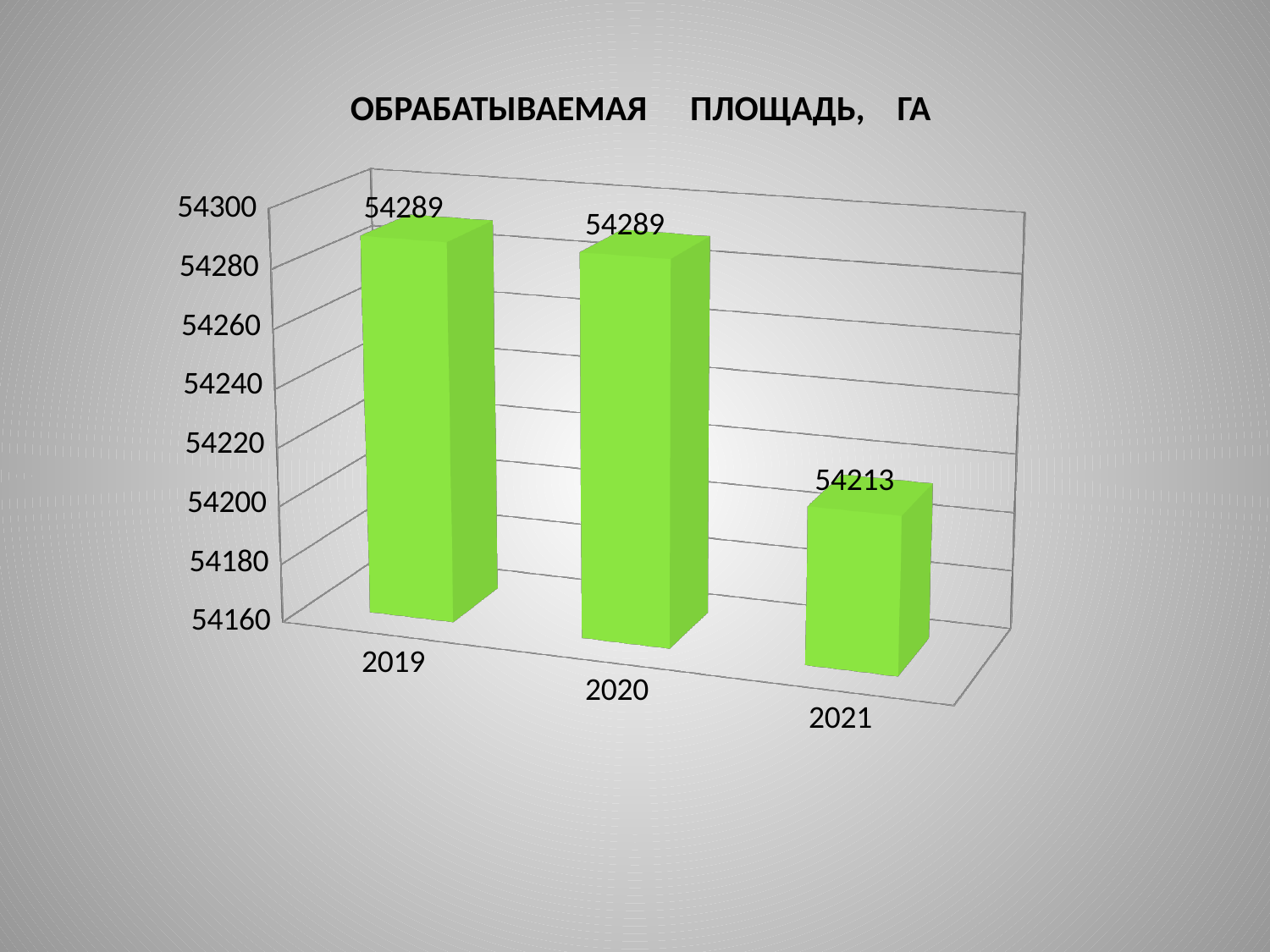
What is the title of the chart? ОБРАБАТЫВАЕМАЯ ПЛОЩАДЬ, ГА Which is larger, the value for 2019 or the value for 2021? 2019 How many years are shown on the chart? 3 Is the value for 2020 greater or less than 54260? greater Is the value for 2021 greater or less than 54240? less What is the value for 2020? 54289 What is the value for 2021? 54213 What is the difference between the values for 2020 and 2021? 76 Do the values rise or fall from 2020 to 2021? fall Which year has the lowest value? 2021 What is the value for 2019? 54289 What kind of chart is shown on the slide? bar chart